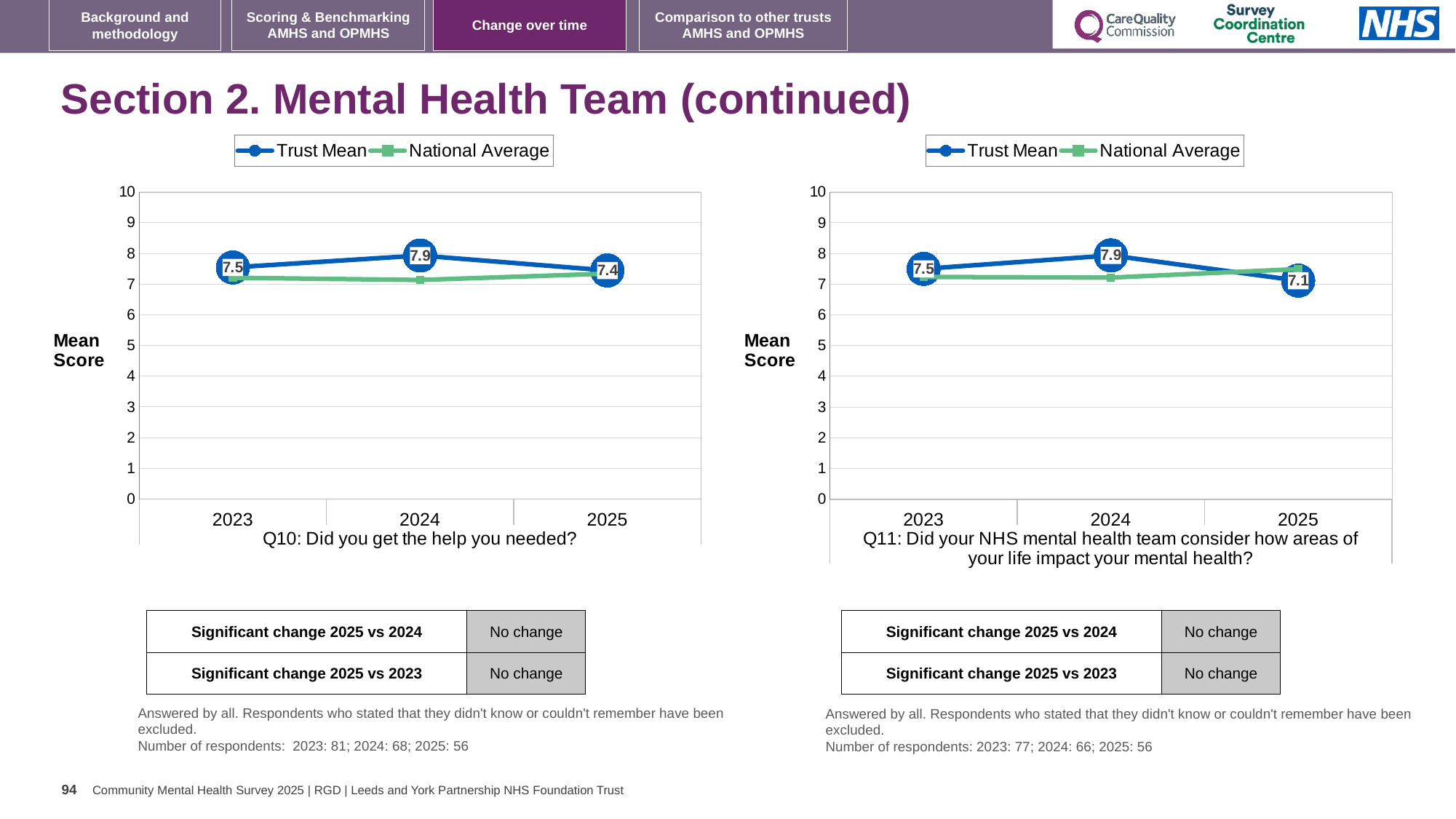
How many years are plotted on the x axis of the Q11 chart (right)? 3 In the Q10 chart (left), what is the Trust Mean for 2025? 7.4 What kind of chart is the Q11 chart (right)? Line chart In the Q11 chart (right), what is the Trust Mean for 2025? 7.1 In the Q10 chart (left), is the Trust Mean for 2023 or 2025 larger? 2023 In the Q11 chart (right), what is the Trust Mean for 2023? 7.5 In the Q10 chart (left), what is the Trust Mean for 2024? 7.9 In the Q11 chart (right), what is the difference between the Trust Mean in 2024 and in 2025? 0.8 In the Q10 chart (left), is the National Average for 2024 greater or less than 8? less How many series does the legend of the Q10 chart (left) list? 2 In the Q10 chart (left), which year has the highest Trust Mean? 2024 In the Q11 chart (right), which year has the lowest Trust Mean? 2025